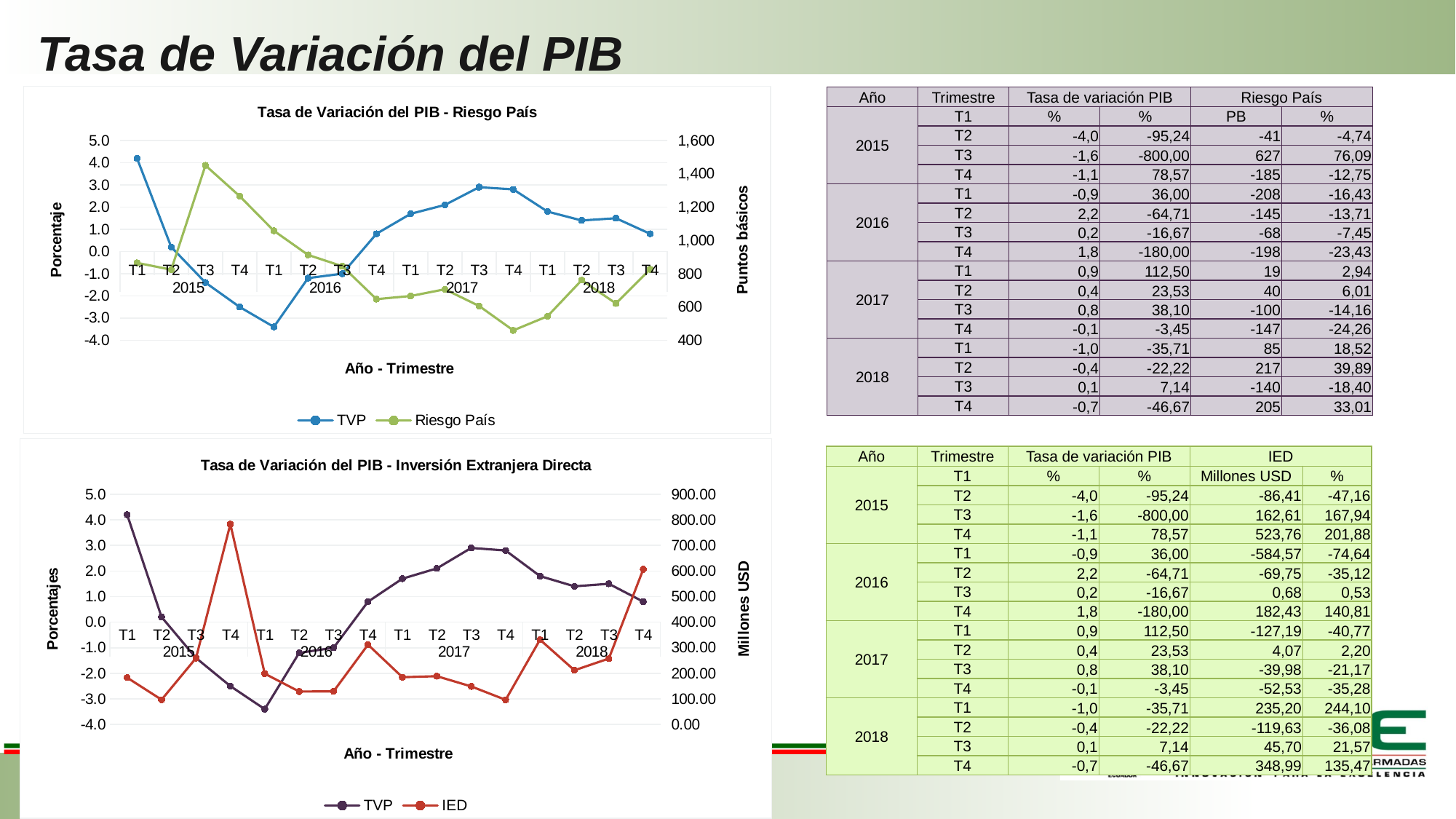
In the bottom chart 'Tasa de Variación del PIB - Inversión Extranjera Directa', is the IED value at T4 2015 greater or less than 700.00? greater In the top chart 'Tasa de Variación del PIB - Riesgo País', is the TVP value at T1 2015 greater or less than 3.0? greater In the top chart 'Tasa de Variación del PIB - Riesgo País', at which quarter is the TVP series highest? T1 2015 In the top chart 'Tasa de Variación del PIB - Riesgo País', how many quarters are plotted along the x axis? 16 In the top chart 'Tasa de Variación del PIB - Riesgo País', at which quarter does the Riesgo País series reach its lowest point? T4 2017 What kind of chart is the top chart, 'Tasa de Variación del PIB - Riesgo País'? line chart In the bottom chart 'Tasa de Variación del PIB - Inversión Extranjera Directa', what is the label of the right-hand vertical axis? Millones USD In the top chart 'Tasa de Variación del PIB - Riesgo País', at which quarter does the Riesgo País series reach its highest point? T3 2015 In the top chart 'Tasa de Variación del PIB - Riesgo País', at which quarter is the TVP series lowest? T1 2016 In the top chart 'Tasa de Variación del PIB - Riesgo País', what are the two legend entries? TVP and Riesgo País In the top chart 'Tasa de Variación del PIB - Riesgo País', how many series does the legend list? 2 In the bottom chart 'Tasa de Variación del PIB - Inversión Extranjera Directa', at which quarter is the IED series highest? T4 2015